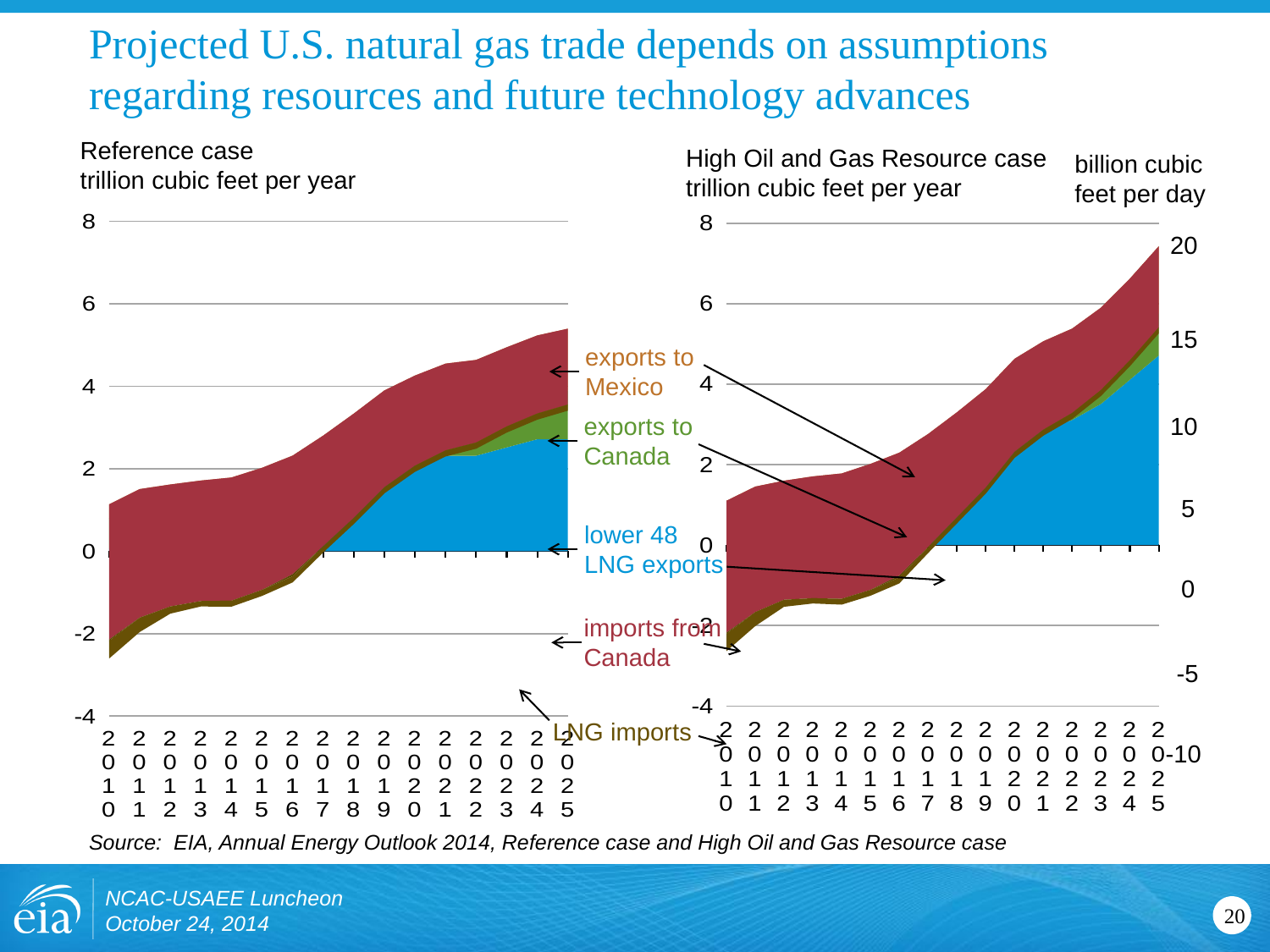
What kind of chart is the Reference case chart? stacked area chart How many years are shown on the x axis of the Reference case chart? 16 In the High Oil and Gas Resource case chart, is the total of the export series in 2025 greater or less than 6? greater What unit is shown on the secondary (right-hand) axis of the High Oil and Gas Resource case chart? billion cubic feet per day Which chart shows the larger total exports in 2025, the Reference case or the High Oil and Gas Resource case? High Oil and Gas Resource case How many series are labelled on the slide's charts? 5 In the High Oil and Gas Resource case chart, is the value for lower 48 LNG exports in 2025 greater or less than 2? greater In the Reference case chart, do total exports rise or fall from 2010 to 2025? rise What unit is shown on the left axis of the Reference case chart? trillion cubic feet per year In the Reference case chart, is the total of the export series in 2010 greater or less than 2? less